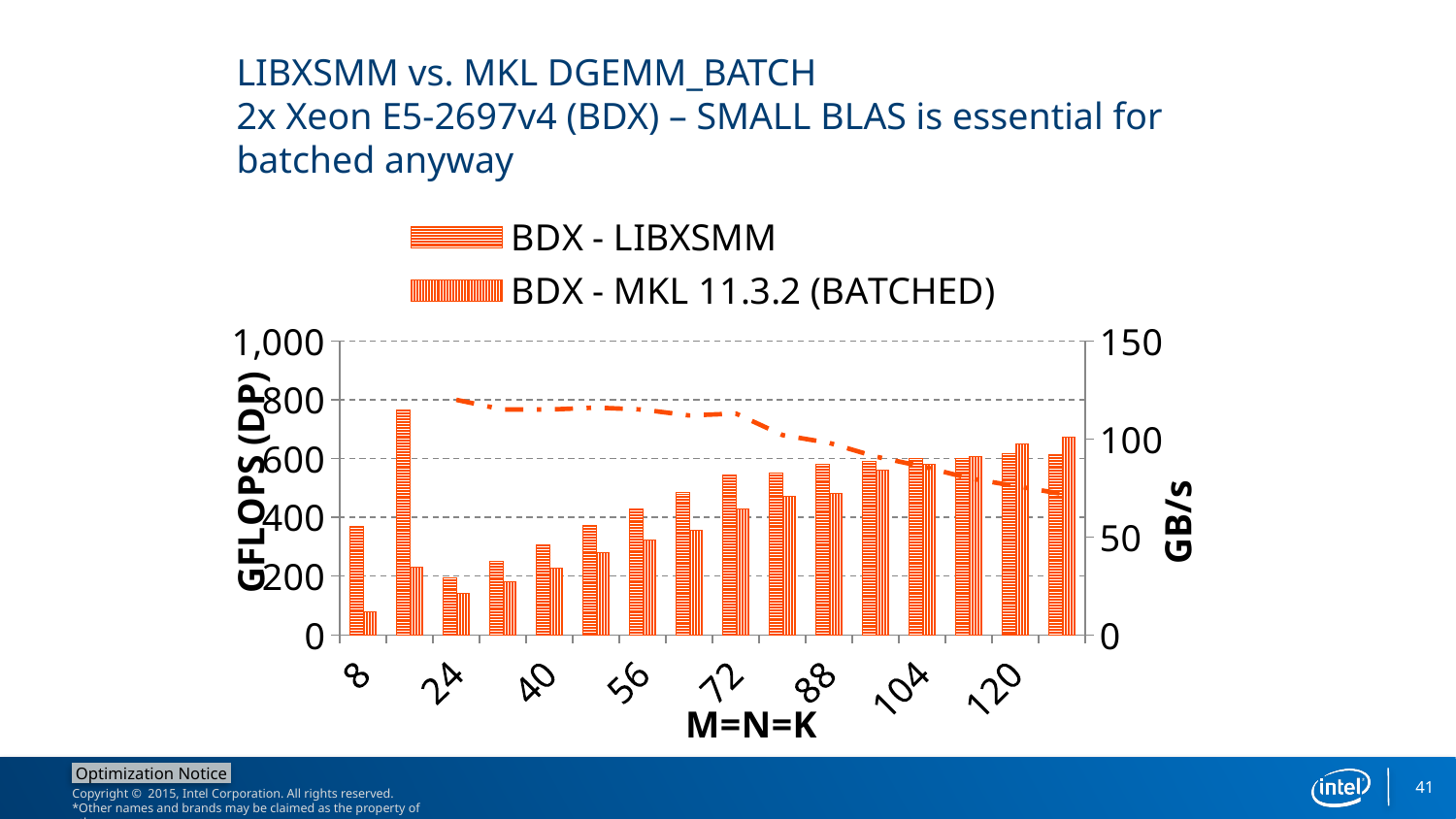
At M=N=K=120, which series has the higher GFLOPS value? BDX - MKL 11.3.2 (BATCHED) Does the dashed line plotted against the right-hand GB/s axis rise or fall from left to right? fall Is the BDX - MKL 11.3.2 (BATCHED) value at M=N=K=8 greater or less than 200 GFLOPS? less Is the BDX - LIBXSMM value at M=N=K=24 greater or less than 400 GFLOPS? less Is the BDX - LIBXSMM value at M=N=K=8 greater or less than 200 GFLOPS? greater What is the title of the left vertical axis? GFLOPS (DP) What kind of chart is shown on the slide? combination bar and line chart How many series does the legend list? 2 At M=N=K=8, which series has the higher GFLOPS value? BDX - LIBXSMM How many category labels are printed along the x axis (M=N=K)? 8 Do the BDX - MKL 11.3.2 (BATCHED) bars generally rise or fall as M=N=K increases? rise